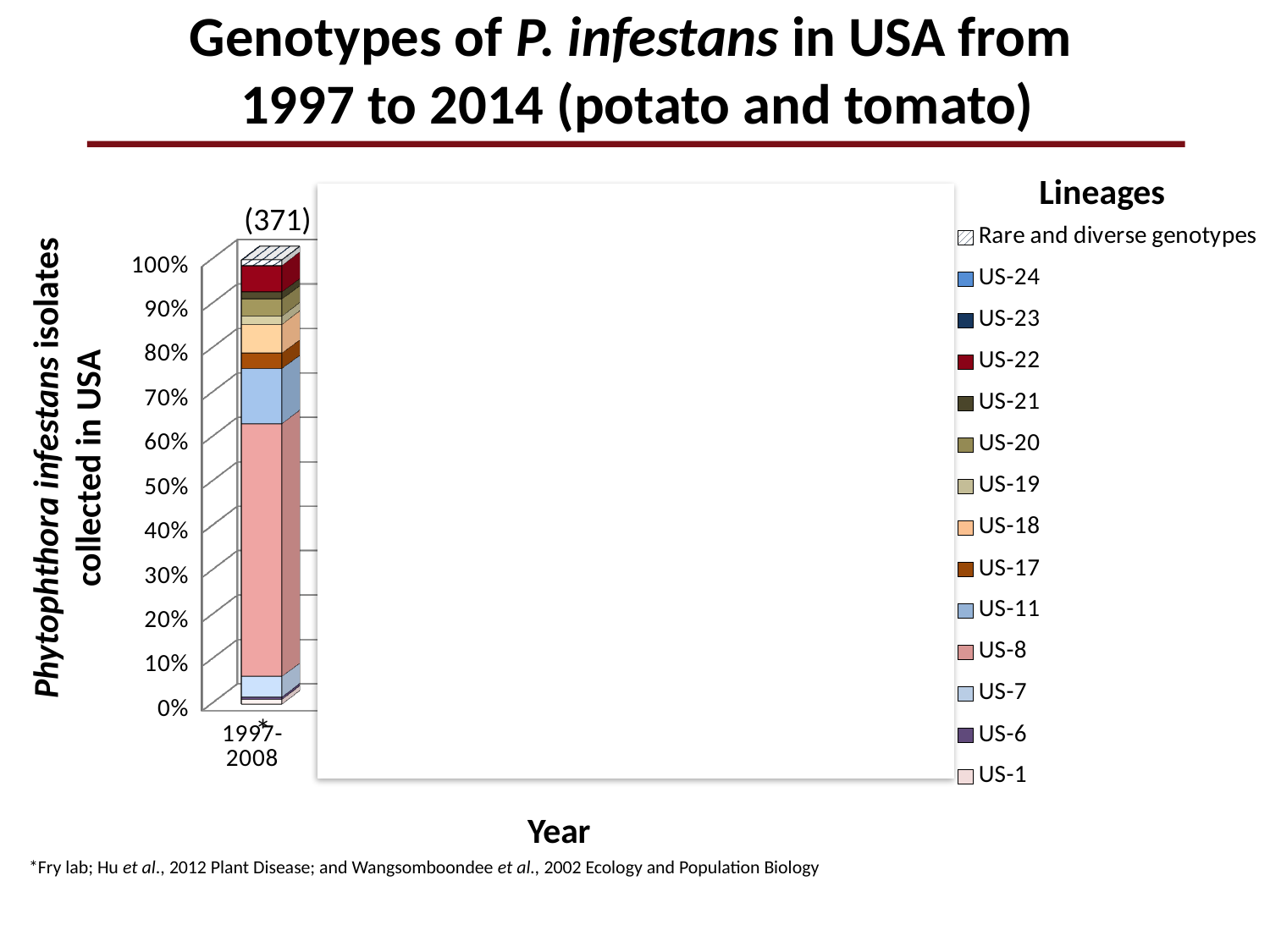
What is the highest value shown on the y-axis? 100% What is the title of the legend? Lineages How many bars are visible in the chart? 1 What number is printed above the 1997-2008 bar? (371) Is the US-8 segment of the 1997-2008 bar greater or less than 50% of the bar? greater Is the US-11 segment of the 1997-2008 bar greater or less than 20% of the bar? less In the 1997-2008 bar, which segment is larger, US-8 or US-11? US-8 How many lineages does the legend list? 14 What is the x-axis title of the chart? Year Which lineage makes up the largest segment of the 1997-2008 bar? US-8 What is the x-axis label of the visible bar? 1997-2008 What kind of chart is shown on the slide? stacked bar chart